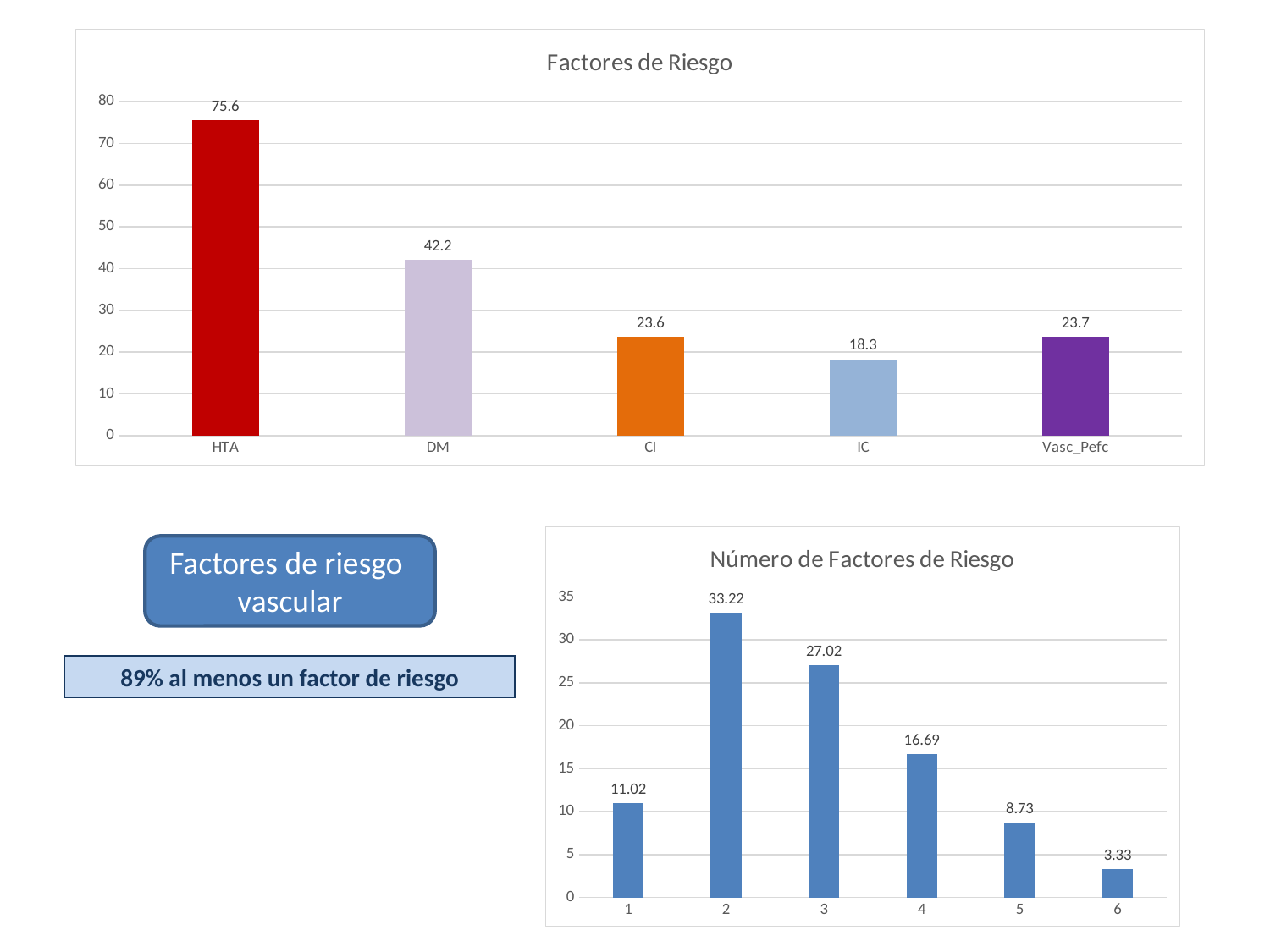
In the 'Factores de Riesgo' chart, what is the value for DM? 42.2 In the 'Factores de Riesgo' chart, which category has the highest value? HTA In the 'Número de Factores de Riesgo' chart, what is the value for category 2? 33.22 In the 'Número de Factores de Riesgo' chart, which category has the highest value? 2 In the 'Factores de Riesgo' chart, what is the difference between the values for HTA and DM? 33.4 In the 'Factores de Riesgo' chart, how many categories are shown? 5 In the 'Factores de Riesgo' chart, what colour is the bar for Vasc_Pefc? Purple What kind of chart is the 'Número de Factores de Riesgo' chart? Bar chart In the 'Factores de Riesgo' chart, what is the value for HTA? 75.6 In the 'Factores de Riesgo' chart, which category has the lowest value? IC In the 'Número de Factores de Riesgo' chart, what is the value for category 6? 3.33 In the 'Número de Factores de Riesgo' chart, is the value for category 3 larger than the value for category 4? Yes